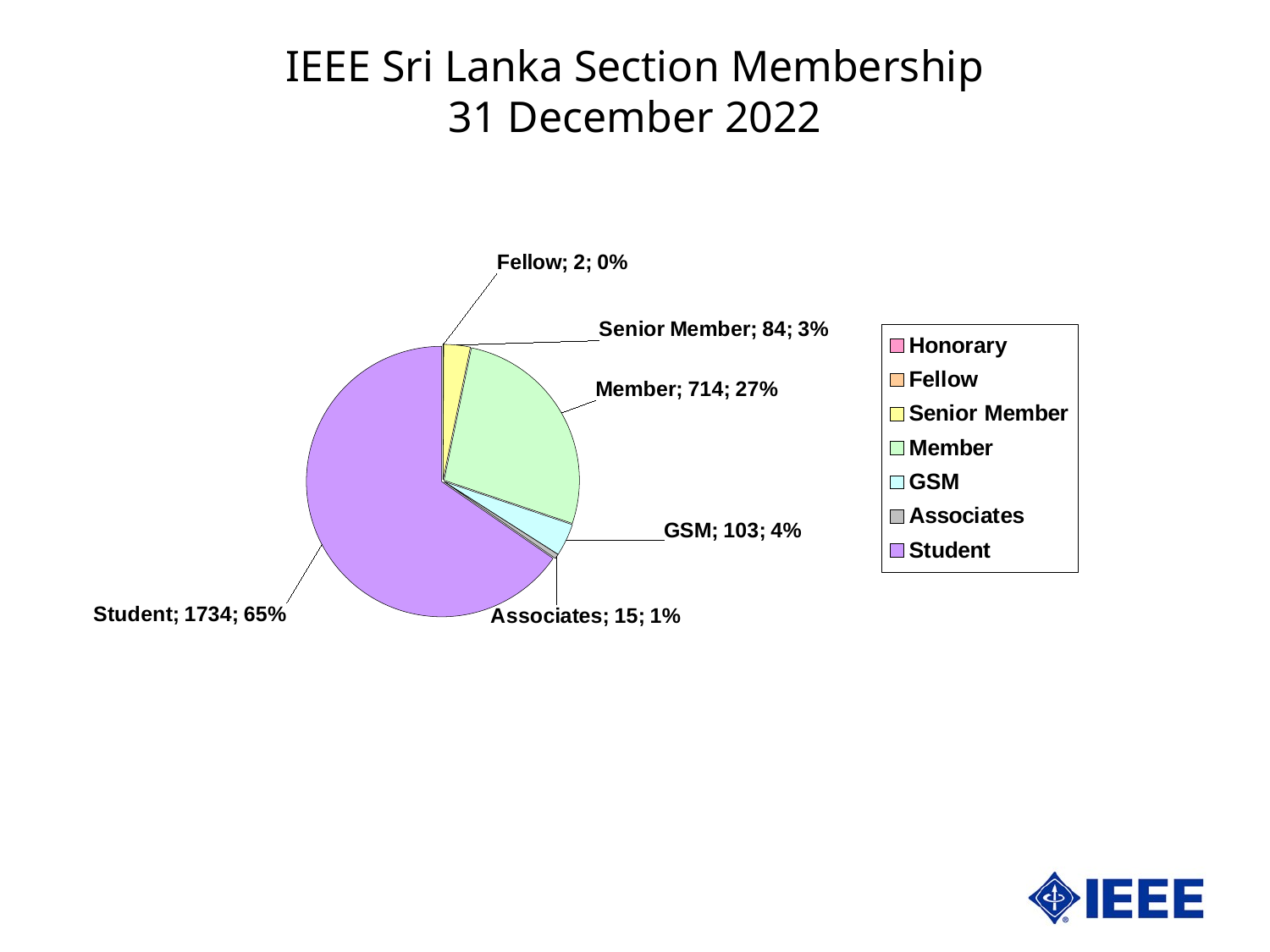
How many entries does the legend list? 7 What share of the pie does the Member category represent? 27% Which labelled category has the smallest value? Fellow What is the title of the chart? IEEE Sri Lanka Section Membership 31 December 2022 What share of the pie does the Senior Member category represent? 3% Which is larger, the GSM count or the Senior Member count? GSM How many members are in the Student category? 1734 Which category has the largest slice of the pie? Student What type of chart is shown on the slide? pie chart What is the difference between the Student count and the Member count? 1020 What is the difference between the Associates count and the Fellow count? 13 How many members are in the GSM category? 103